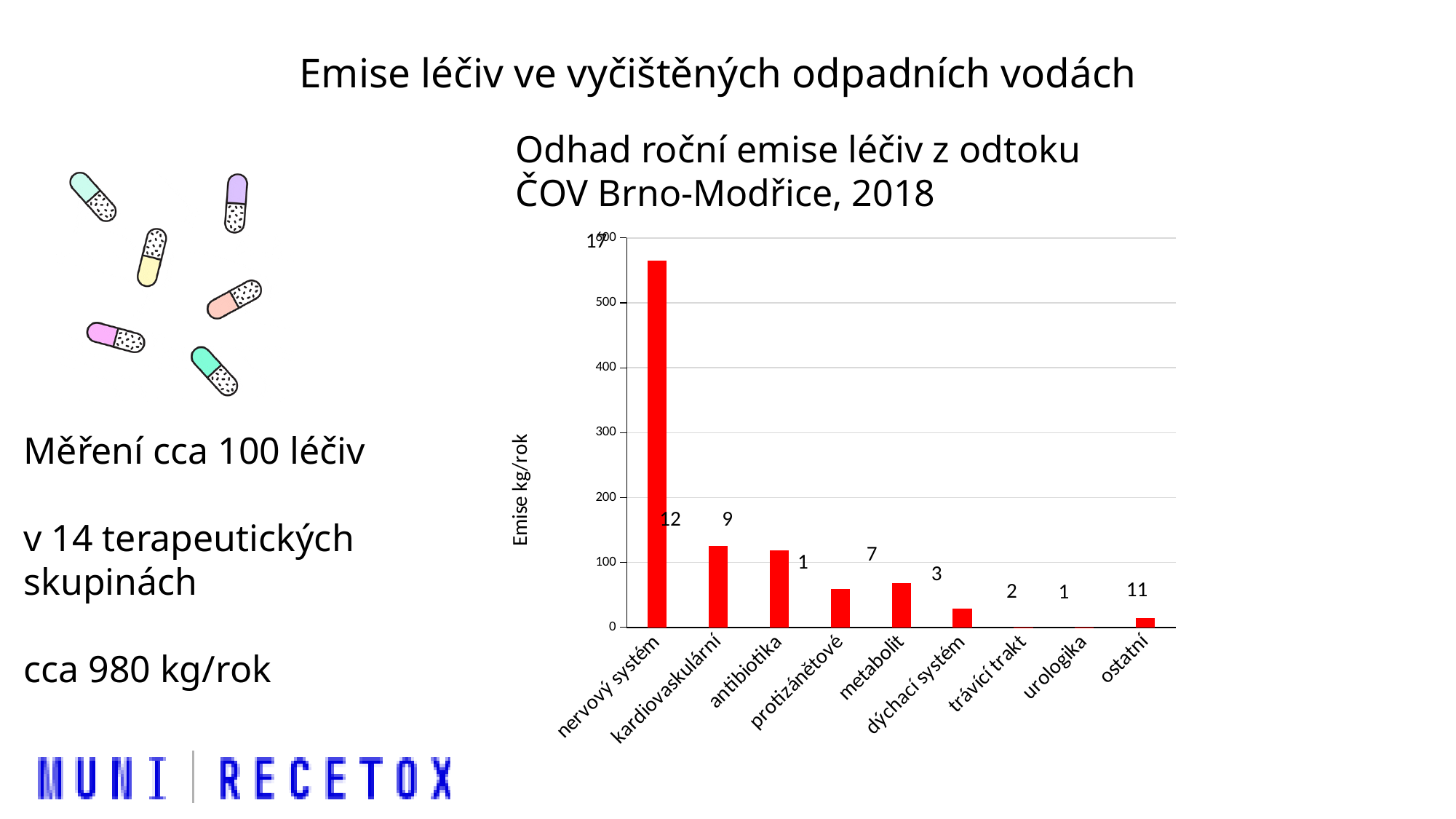
Which category has the highest emission in the chart? nervový systém What kind of chart is shown on the slide? bar chart Is the value for dýchací systém greater or less than 100? less Which has a higher emission value, dýchací systém or metabolit? metabolit How many categories (therapeutic groups) are shown on the x axis of the chart? 9 Which has a higher emission value, antibiotika or ostatní? antibiotika Which has a higher emission value, nervový systém or kardiovaskulární? nervový systém What is the label of the y axis of the chart? Emise kg/rok Is the value for protizánětové greater or less than 100? less Is the value for nervový systém greater or less than 500? greater What colour are the bars in the chart? red